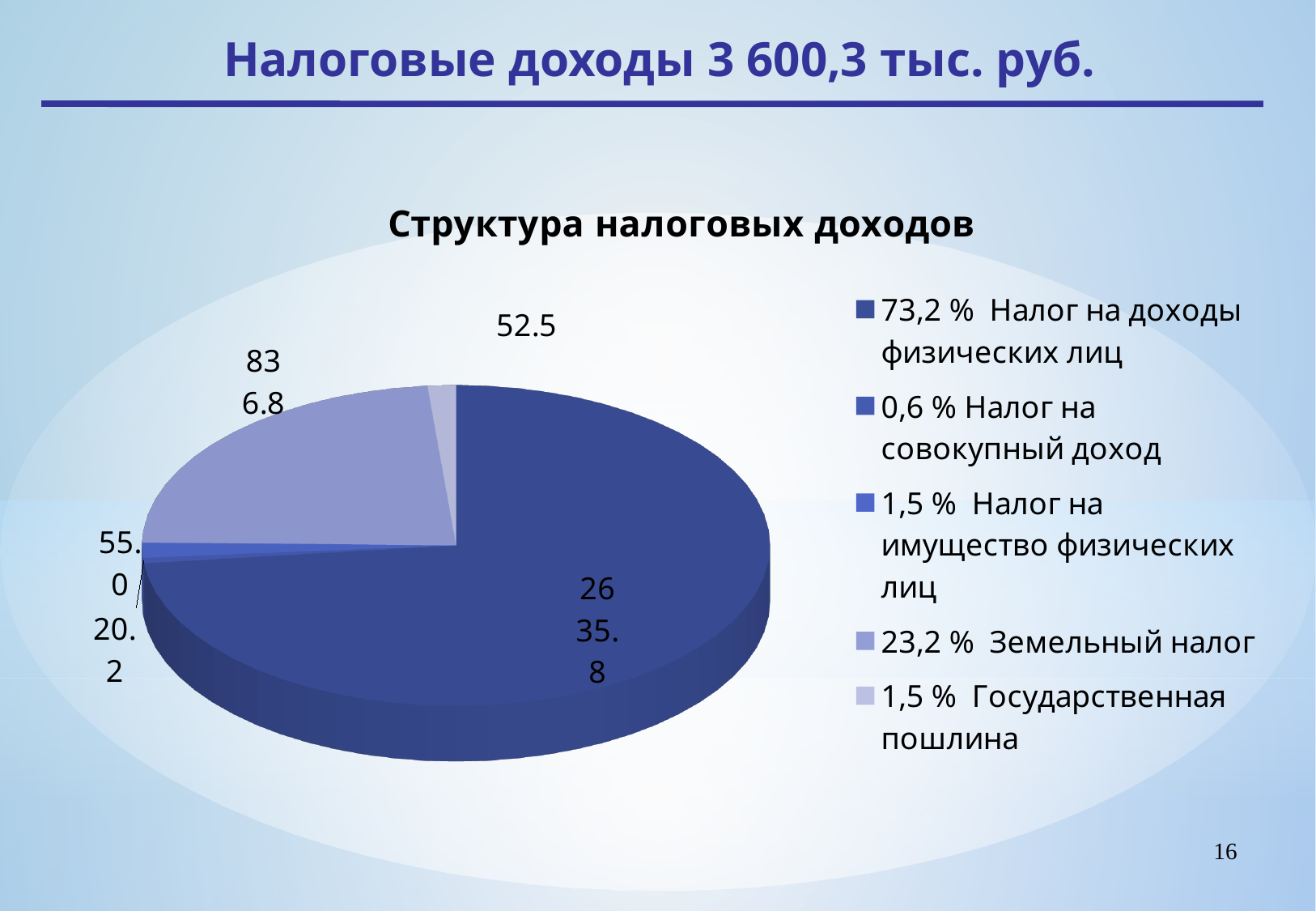
What kind of chart is shown on the slide? pie chart What share of the pie does Земельный налог have? 23,2 % Which category has the smallest share of the pie? Налог на совокупный доход By how many percentage points does the share of Налог на доходы физических лиц exceed the share of Земельный налог? 50 Which is larger: the share of Земельный налог or the share of Налог на имущество физических лиц? Земельный налог What percentage is shown in the legend for Государственная пошлина? 1,5 % What percentage is shown in the legend for Налог на совокупный доход? 0,6 % What is the title of the chart? Структура налоговых доходов What share of the pie does Налог на доходы физических лиц have? 73,2 % How many slices does the pie chart have? 5 What total amount of tax revenue is stated in the slide heading? 3 600,3 тыс. руб. Which category has the largest share of the pie? Налог на доходы физических лиц